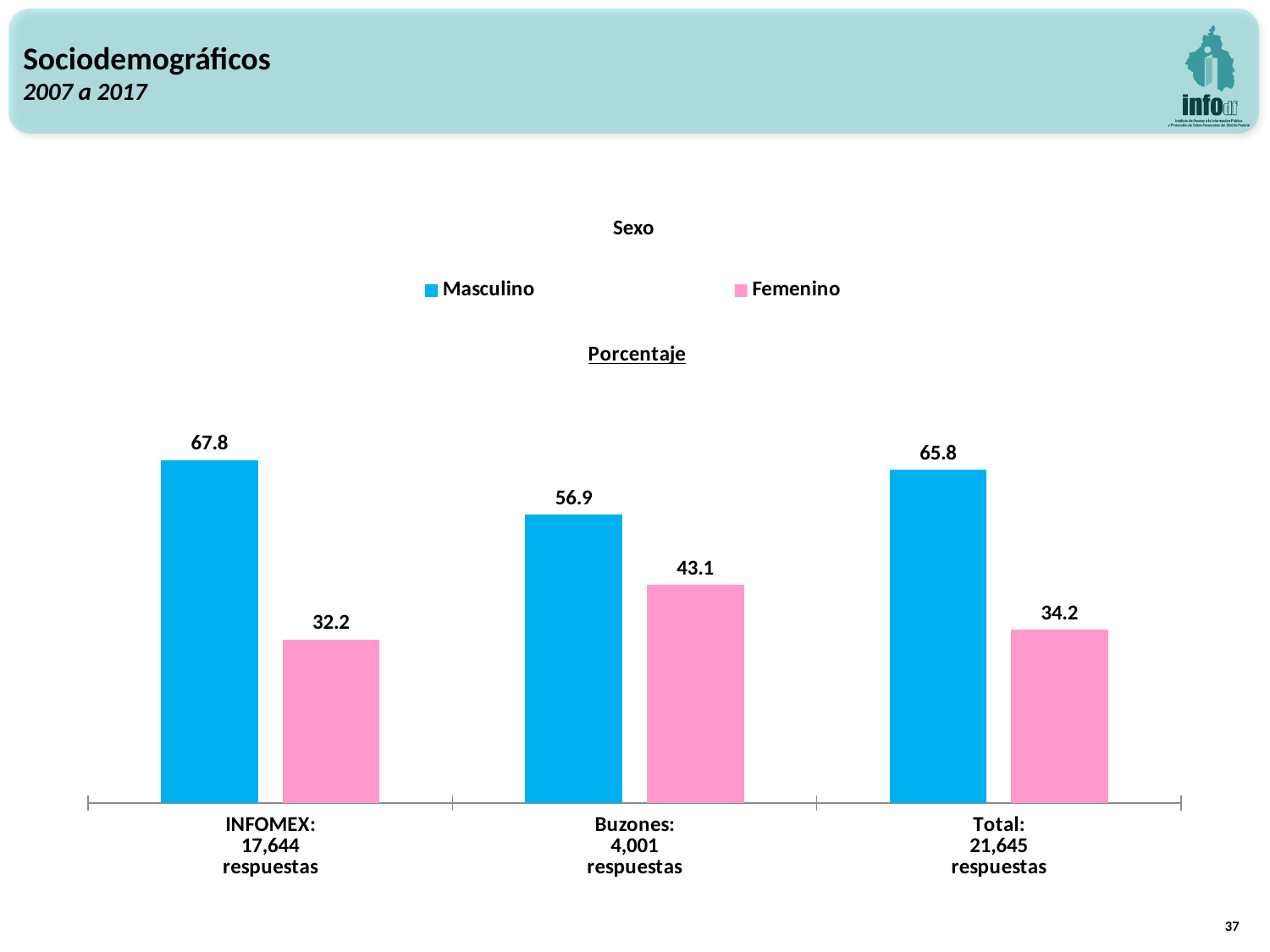
How many series does the legend list? 2 What is the Femenino value for Buzones? 43.1 What is the title of the chart? Porcentaje What is the difference between the Masculino values for INFOMEX and Total? 2.0 Which is larger for Total, the Masculino value or the Femenino value? Masculino What is the Masculino value for INFOMEX? 67.8 How many categories are shown on the x axis? 3 Which category has the lowest Femenino value? INFOMEX Which category has the highest Masculino value? INFOMEX What is the Femenino value for Total? 34.2 What is the difference between the Masculino and Femenino values for Buzones? 13.8 What kind of chart is shown on the slide? Bar chart